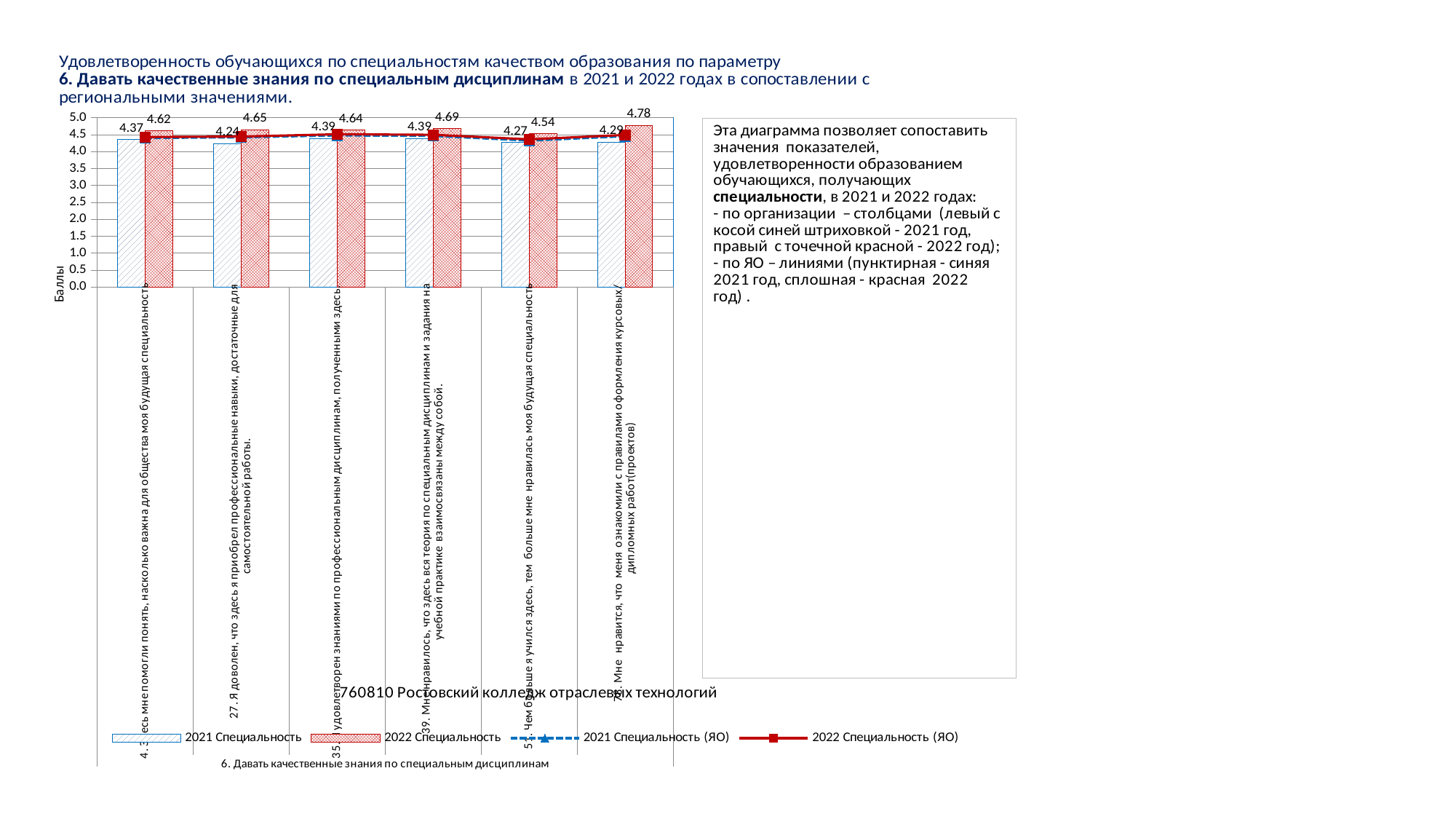
What is the label of the vertical axis? Баллы What is the difference between the 2022 Специальность values of the sixth and fifth categories? 0.24 What is the 2022 Специальность value for category 27 (Я доволен, что здесь я приобрел профессиональные навыки...)? 4.65 For category 39, which is larger: the 2021 Специальность value or the 2022 Специальность value? 2022 Специальность (4.69) How many series does the legend list? 4 What is the 2021 Специальность value for category 39 (Мне нравилось, что здесь вся теория по специальным дисциплинам...)? 4.39 What is the 2022 Специальность value for the fifth category from the left? 4.54 Which category has the highest 2022 Специальность value? The sixth (rightmost) category, 4.78 Is the 2021 Специальность value for the first category greater or less than 4.0? greater How many categories are shown on the x axis? 6 Which category has the lowest 2021 Специальность value? Category 27 (second from left), 4.24 What is the difference between the 2022 and 2021 Специальность values for category 27? 0.41